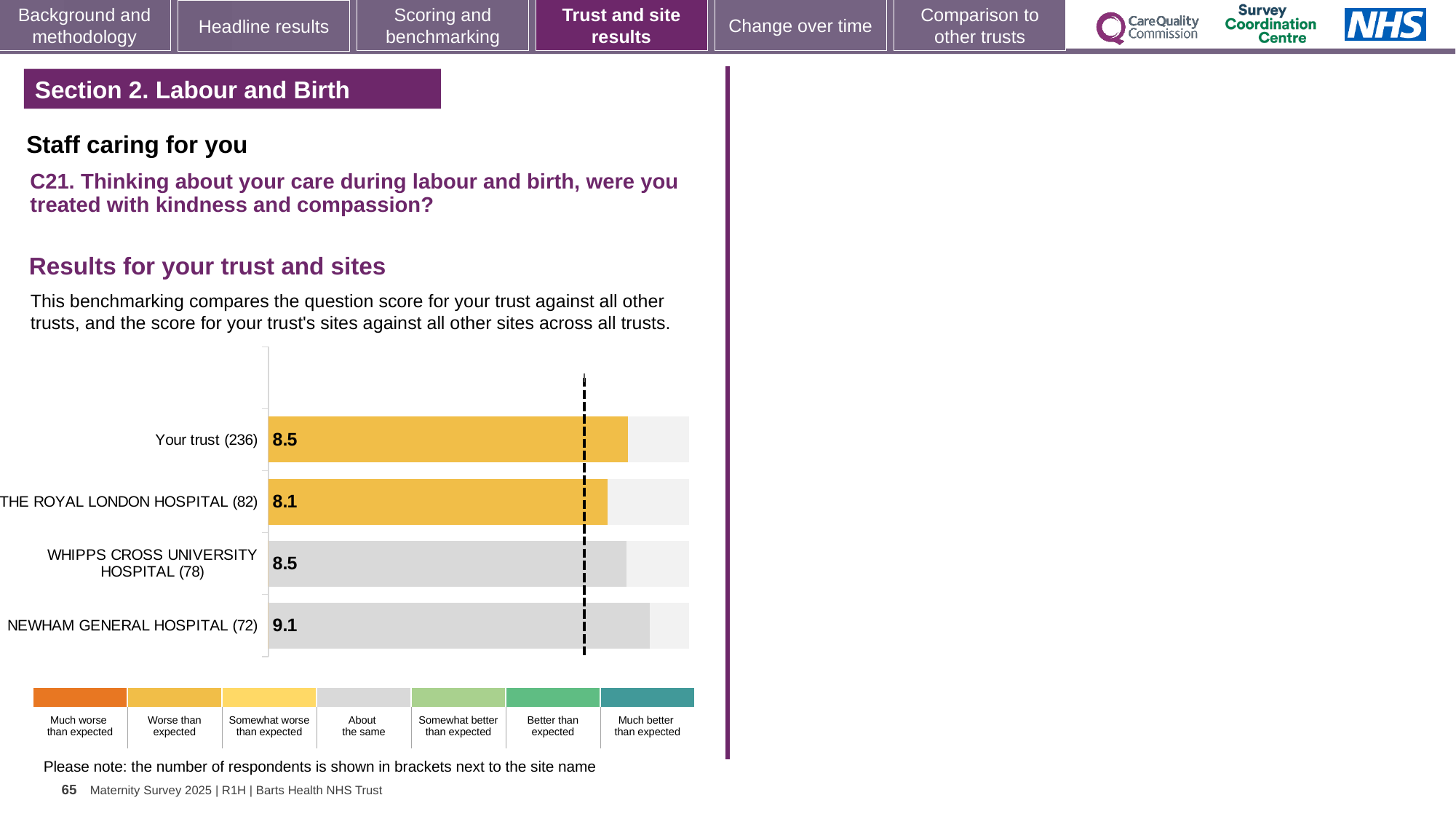
What is the score for Newham General Hospital? 9.1 What is the score for The Royal London Hospital? 8.1 According to the colour key, which benchmark category does the bar for The Royal London Hospital fall into? Worse than expected How many bars are shown in the chart? 4 What kind of chart is shown on the slide? Bar chart Which has the larger score, Newham General Hospital or Whipps Cross University Hospital? Newham General Hospital How many respondents are shown in brackets for Your trust? 236 What is the score for Your trust? 8.5 What is the score for Whipps Cross University Hospital? 8.5 Which site has the lowest score? The Royal London Hospital What is the difference between the scores for Newham General Hospital and The Royal London Hospital? 1.0 Which site has the highest score? Newham General Hospital